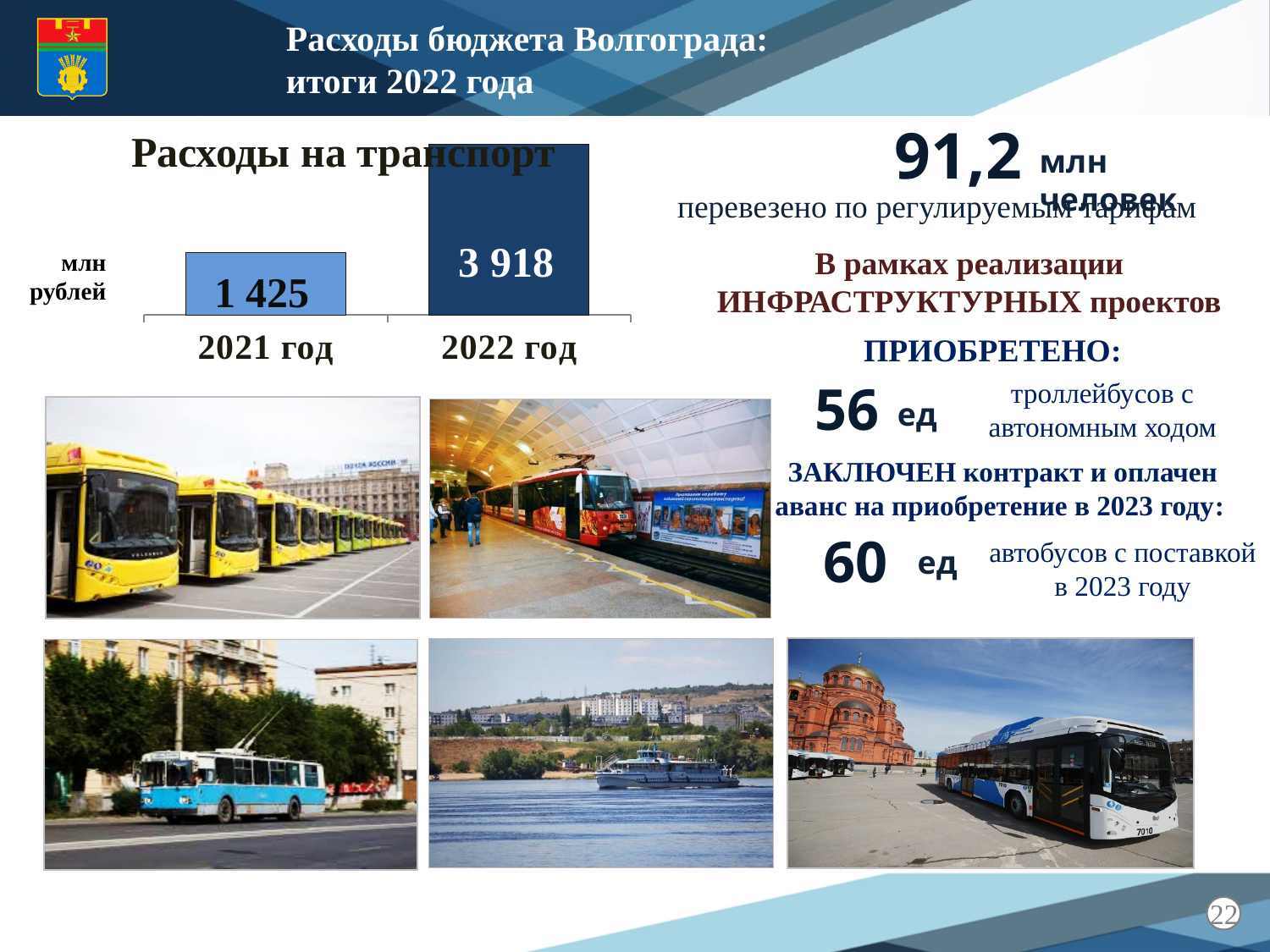
What is the title of the chart on the slide? Расходы на транспорт What is the value for 2022 год in the Расходы на транспорт chart? 3 918 Do the values in the Расходы на транспорт chart rise or fall from 2021 год to 2022 год? rise How many categories are shown in the Расходы на транспорт chart? 2 What is the difference between the values for 2022 год and 2021 год in the Расходы на транспорт chart? 2 493 Which year has the highest value in the Расходы на транспорт chart? 2022 год In what units are the values of the Расходы на транспорт chart given? млн рублей Which year has the lowest value in the Расходы на транспорт chart? 2021 год What is the value for 2021 год in the Расходы на транспорт chart? 1 425 In the Расходы на транспорт chart, which is larger: the value for 2021 год or for 2022 год? 2022 год What kind of chart is the Расходы на транспорт chart? bar chart